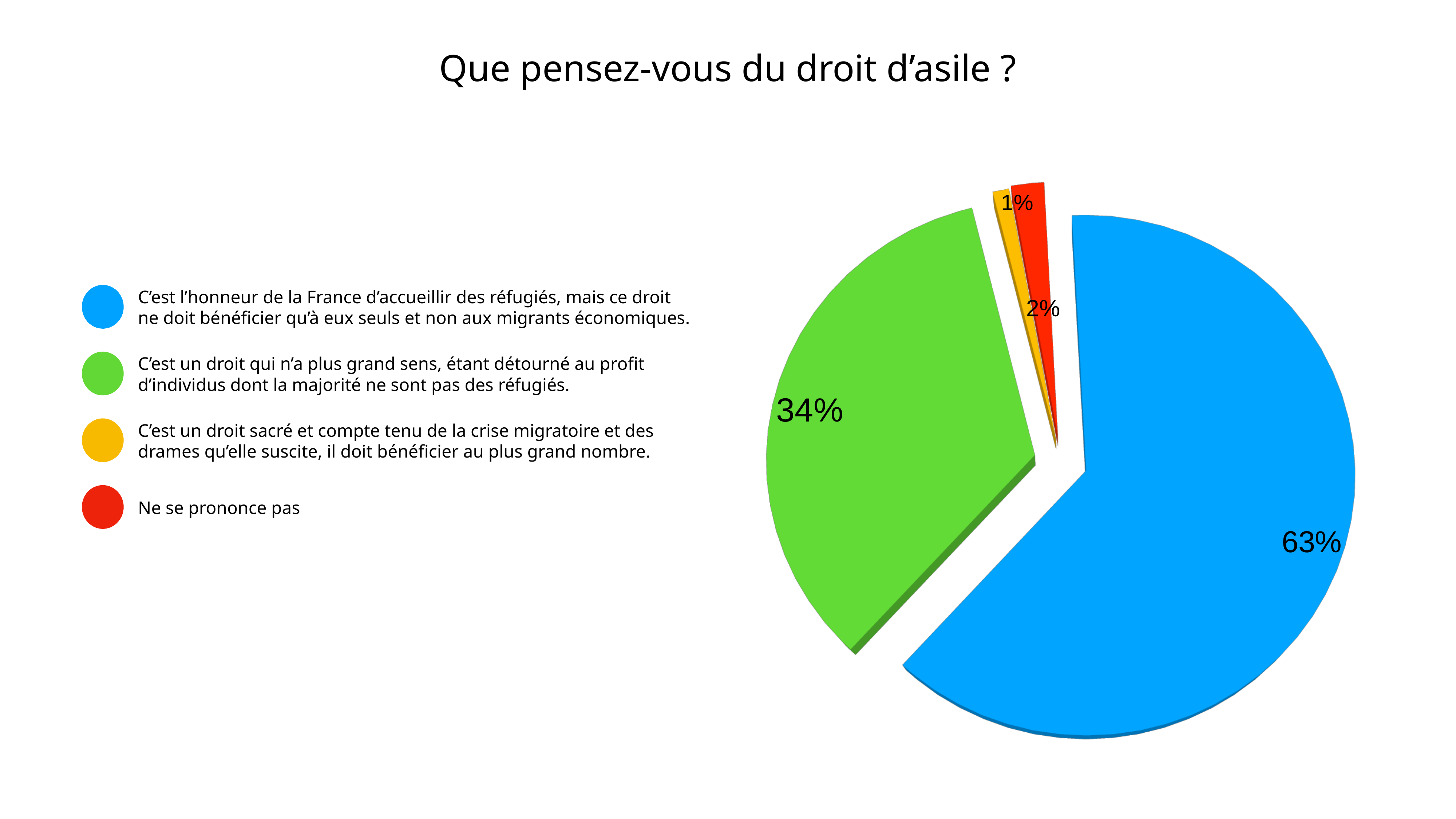
What is the difference in percentage points between the largest slice (63%) and the second largest slice (34%)? 29 Which response has the largest share of the pie? C'est l'honneur de la France d'accueillir des réfugiés, mais ce droit ne doit bénéficier qu'à eux seuls et non aux migrants économiques. What is the title of the chart? Que pensez-vous du droit d'asile ? What percentage of respondents chose "C'est un droit sacré et compte tenu de la crise migratoire et des drames qu'elle suscite, il doit bénéficier au plus grand nombre"? 1% How many slices does the pie chart have? 4 What kind of chart is shown on the slide? pie chart What colour is the slice representing "Ne se prononce pas"? red What percentage of respondents answered "Ne se prononce pas"? 2% What percentage of respondents chose "C'est l'honneur de la France d'accueillir des réfugiés, mais ce droit ne doit bénéficier qu'à eux seuls et non aux migrants économiques"? 63% Which response has the smallest share of the pie? C'est un droit sacré et compte tenu de la crise migratoire et des drames qu'elle suscite, il doit bénéficier au plus grand nombre. What percentage of respondents chose "C'est un droit qui n'a plus grand sens, étant détourné au profit d'individus dont la majorité ne sont pas des réfugiés"? 34% Which is larger: the share for "C'est un droit qui n'a plus grand sens..." or the share for "Ne se prononce pas"? C'est un droit qui n'a plus grand sens...